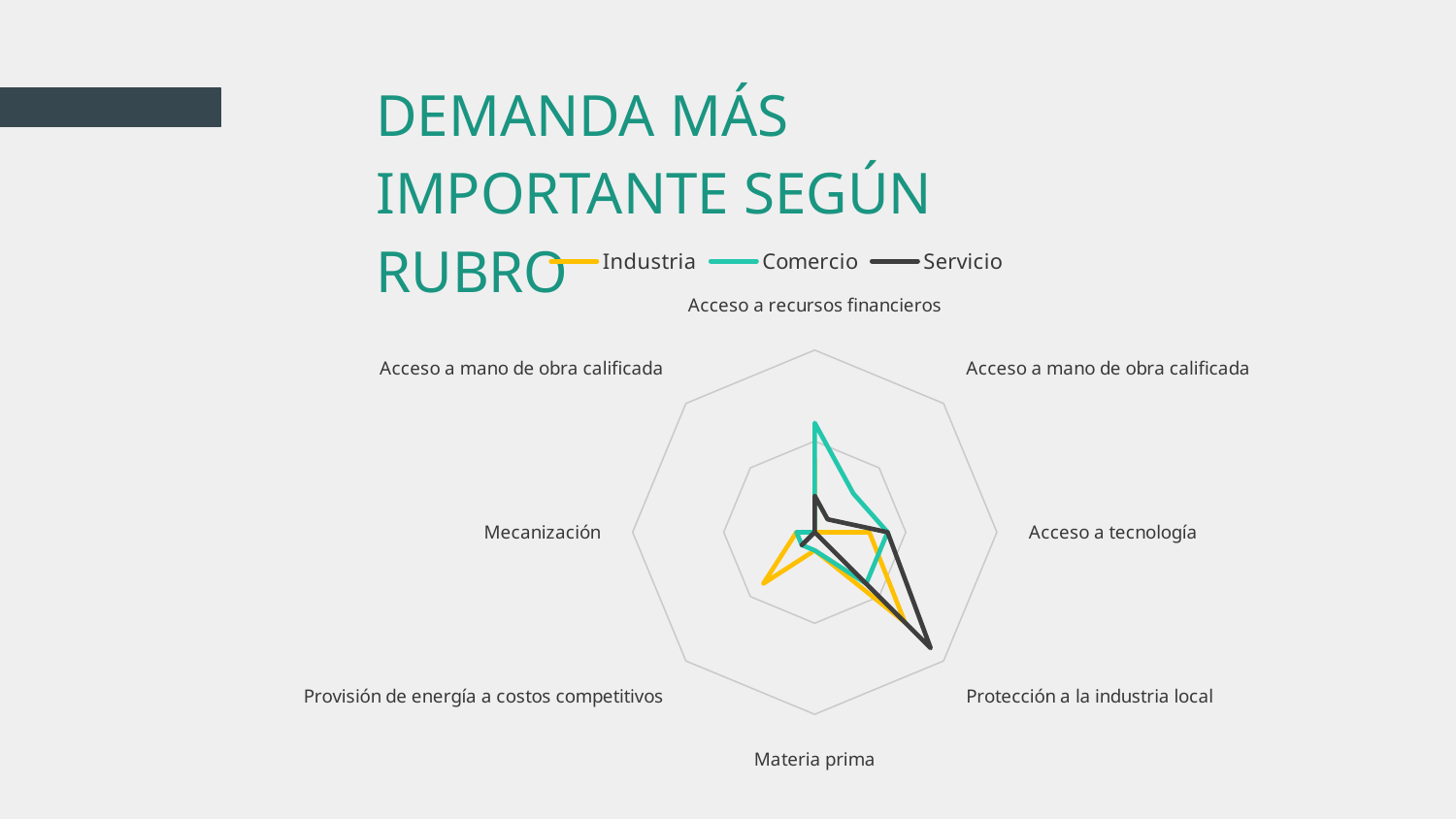
Which series reaches the furthest out on the 'Protección a la industria local' axis? Servicio How many category axes does the radar chart have? 8 For the Servicio series, on which axis is its value highest? Protección a la industria local Which series reaches the furthest out on the 'Provisión de energía a costos competitivos' axis? Industria Which series are listed in the chart legend? Industria, Comercio, Servicio For the Comercio series, on which axis is its value highest? Acceso a recursos financieros What is the title of the slide containing the radar chart? DEMANDA MÁS IMPORTANTE SEGÚN RUBRO Which series reaches the furthest out on the 'Acceso a recursos financieros' axis? Comercio Which category label appears at the bottom of the radar chart? Materia prima How many series does the legend of the chart list? 3 What kind of chart is shown on the slide? Radar chart